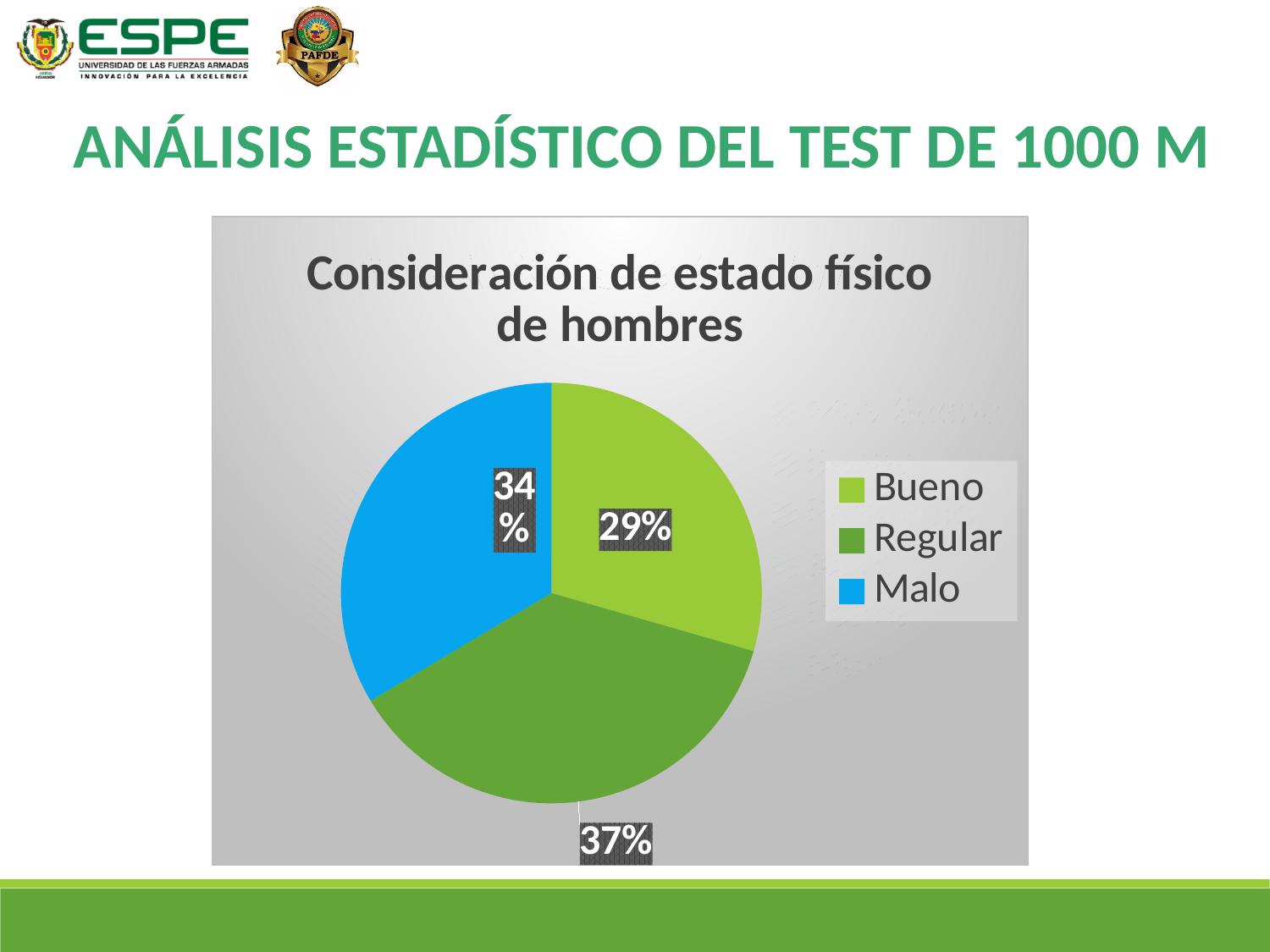
Which category has the largest share of the pie? Regular What percentage of the pie is labelled Regular? 37% What percentage of the pie is labelled Bueno? 29% Which category has the smallest share of the pie? Bueno What is the title of the chart? Consideración de estado físico de hombres Which is larger, the share for Malo or the share for Bueno? Malo How many categories does the pie chart have? 3 What percentage of the pie is labelled Malo? 34% How many entries does the legend list? 3 What is the difference in percentage points between Regular and Bueno? 8 What kind of chart is shown on the slide? pie chart What colour is the Malo slice? blue